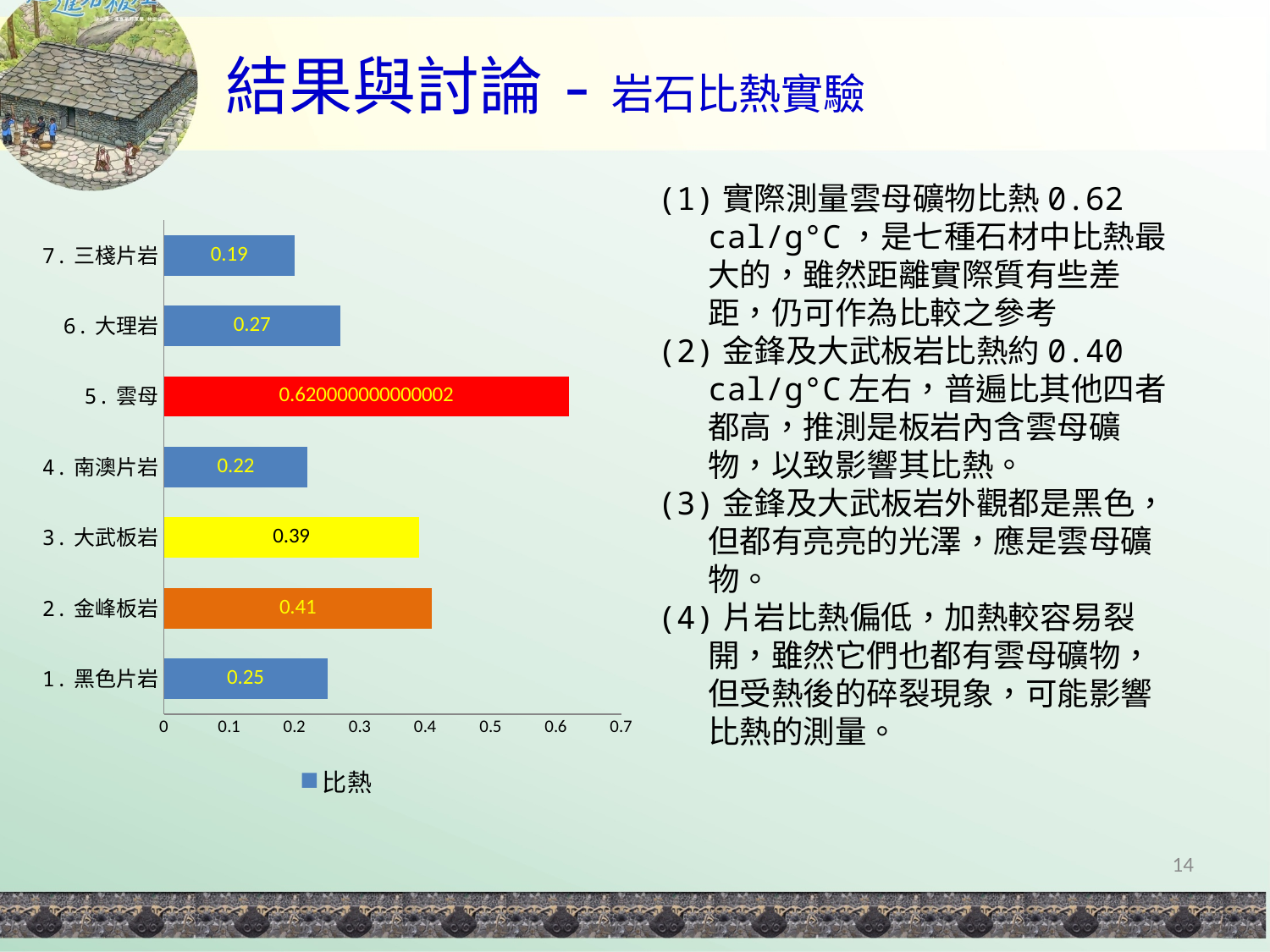
What kind of chart is shown on the slide? bar chart What is the value for 6.大理岩? 0.27 Which category has the lowest value? 7.三棧片岩 How many categories are shown in the chart? 7 What is the difference between the values for 2.金峰板岩 and 3.大武板岩? 0.02 What is the value for 4.南澳片岩? 0.22 Which is larger, the value for 6.大理岩 or the value for 1.黑色片岩? 6.大理岩 What series name does the legend show? 比熱 What is the value for 2.金峰板岩? 0.41 What is the value for 3.大武板岩? 0.39 Which category has the highest value? 5.雲母 What is the value for 1.黑色片岩? 0.25